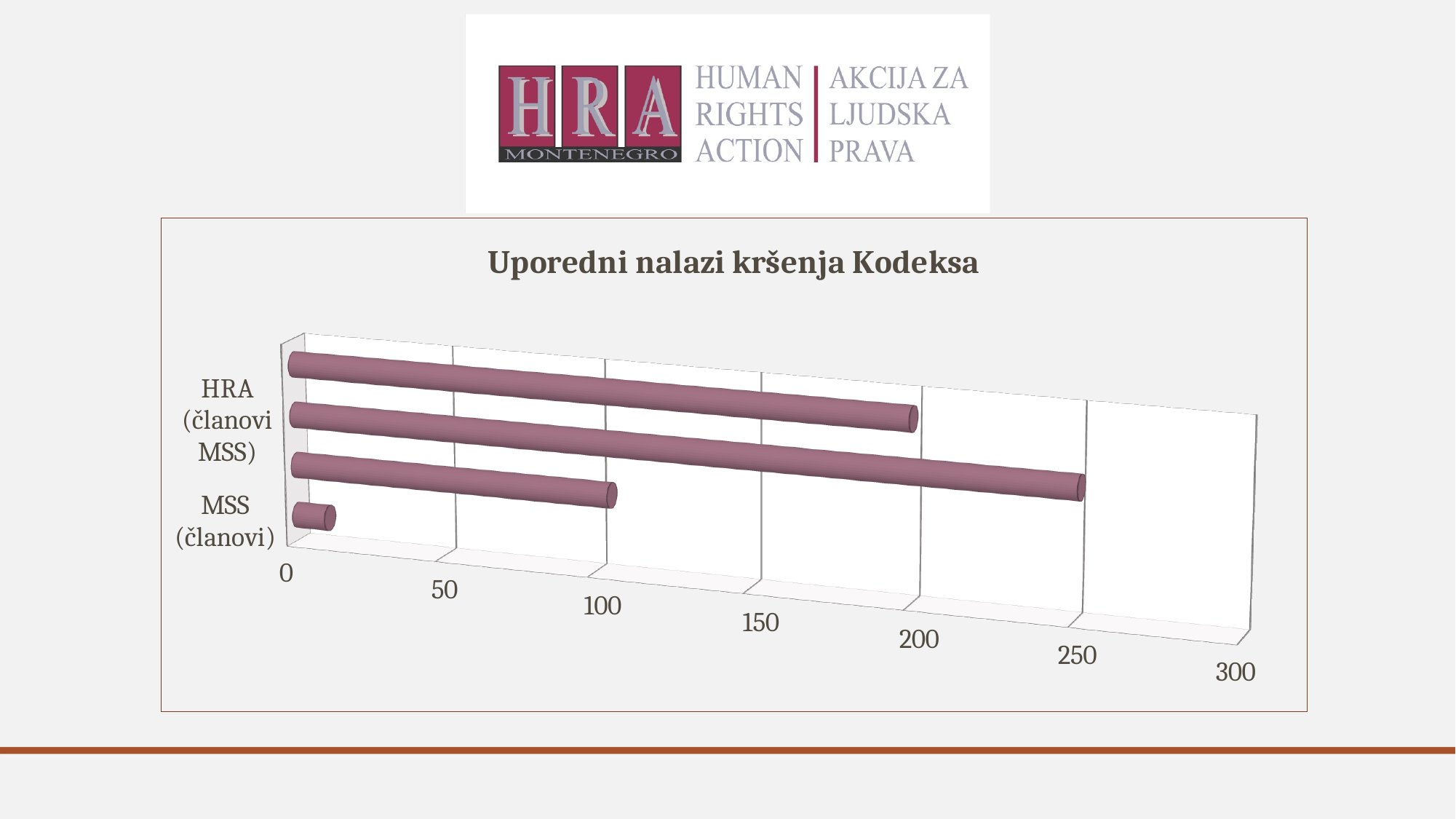
What is the title of the chart? Uporedni nalazi kršenja Kodeksa Which bar is the longest in the chart? the second bar from the top What kind of chart is shown on the slide? bar chart Is the value of the third bar from the top greater or less than 150? less Is the value of the third bar from the top greater or less than 50? greater Is the value of the top bar greater or less than 150? greater How many bars are plotted in the chart? 4 Which bar is the shortest in the chart? the bottom bar Which is larger, the top bar or the third bar from the top? the top bar What is the highest value shown on the horizontal axis? 300